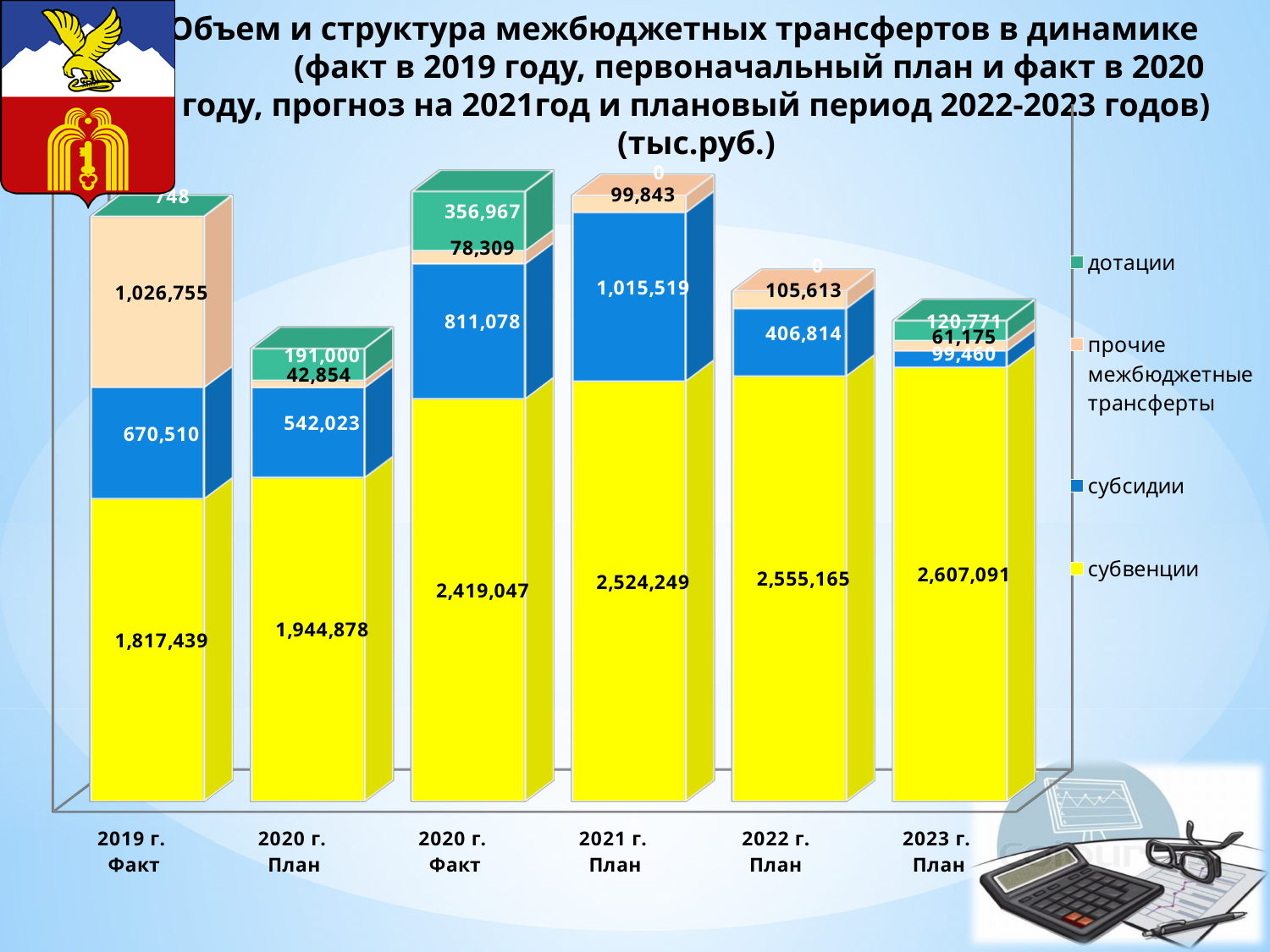
How many categories are shown along the x axis? 6 What is the total of the stacked bar for 2022 г. План? 3,067,592 What is the value of дотации for 2023 г. План? 120,771 What is the value of субсидии for 2021 г. План? 1,015,519 Which is larger: субсидии for 2020 г. Факт or субсидии for 2022 г. План? 2020 г. Факт What is the value of прочие межбюджетные трансферты for 2022 г. План? 105,613 What is the difference between субвенции for 2020 г. Факт and 2020 г. План? 474,169 How many series does the legend list? 4 Which category has the lowest value of субсидии? 2023 г. План What is the value of субвенции for 2020 г. Факт? 2,419,047 Which category has the highest value of субвенции? 2023 г. План What type of chart is shown on the slide? Stacked bar chart